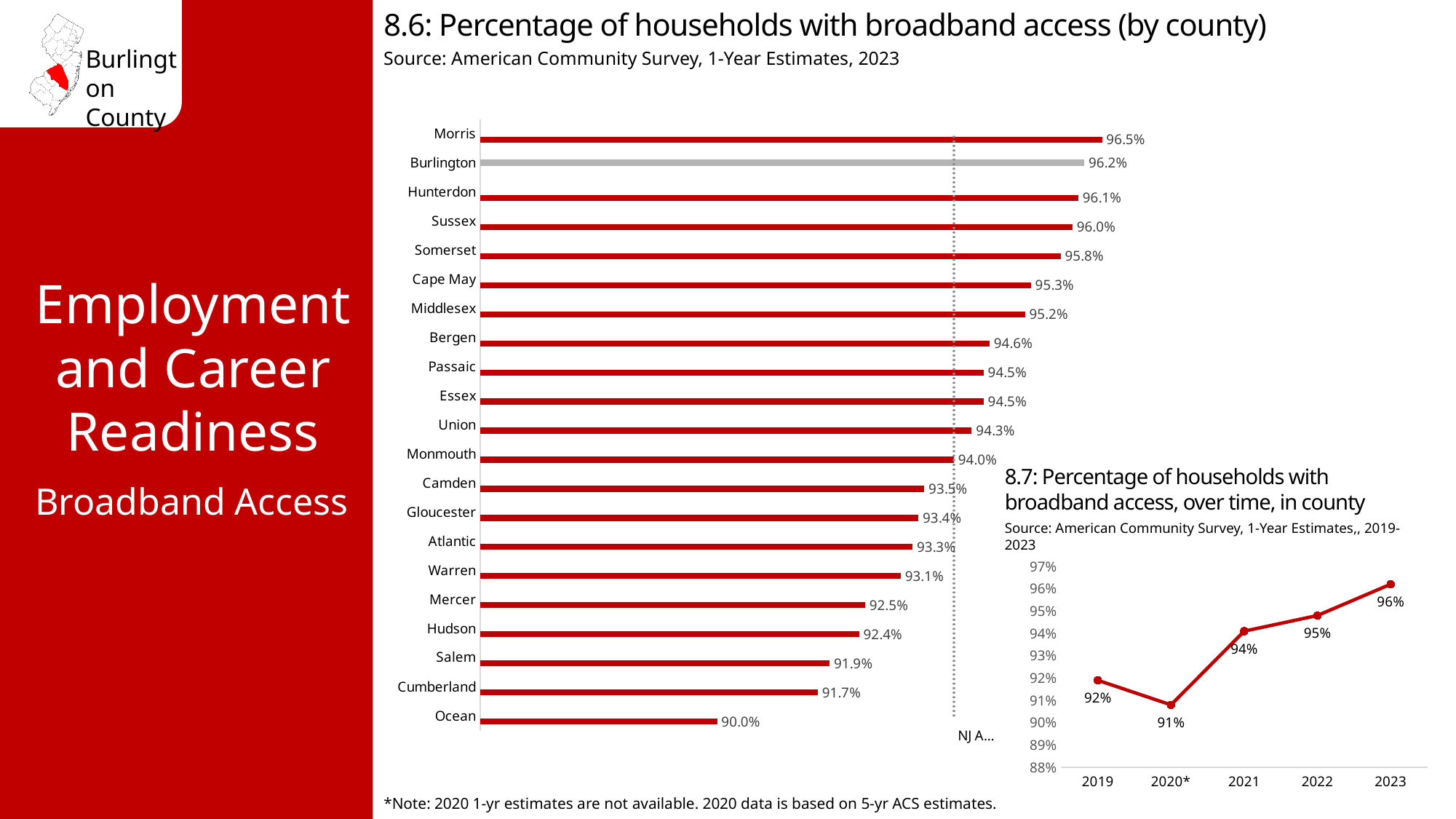
In chart 8.6, which county has a higher value, Camden or Mercer? Camden In chart 8.6, what is the percentage of households with broadband access in Burlington County? 96.2% In chart 8.6, how many counties are shown? 21 In chart 8.7, what is the difference between the 2023 value and the 2019 value? 4% In chart 8.7, what is the percentage of households with broadband access in 2021? 94% In chart 8.6, what is the value shown for Ocean County? 90.0% In chart 8.6, what is the difference between Morris County's value and Ocean County's value? 6.5% What kind of chart is chart 8.6? Bar chart In chart 8.7, which year has the lowest percentage of households with broadband access? 2020* In chart 8.7, do the values generally rise or fall from 2020 to 2023? Rise In chart 8.6, which county has the highest percentage of households with broadband access? Morris In chart 8.6, which county has the lowest percentage of households with broadband access? Ocean